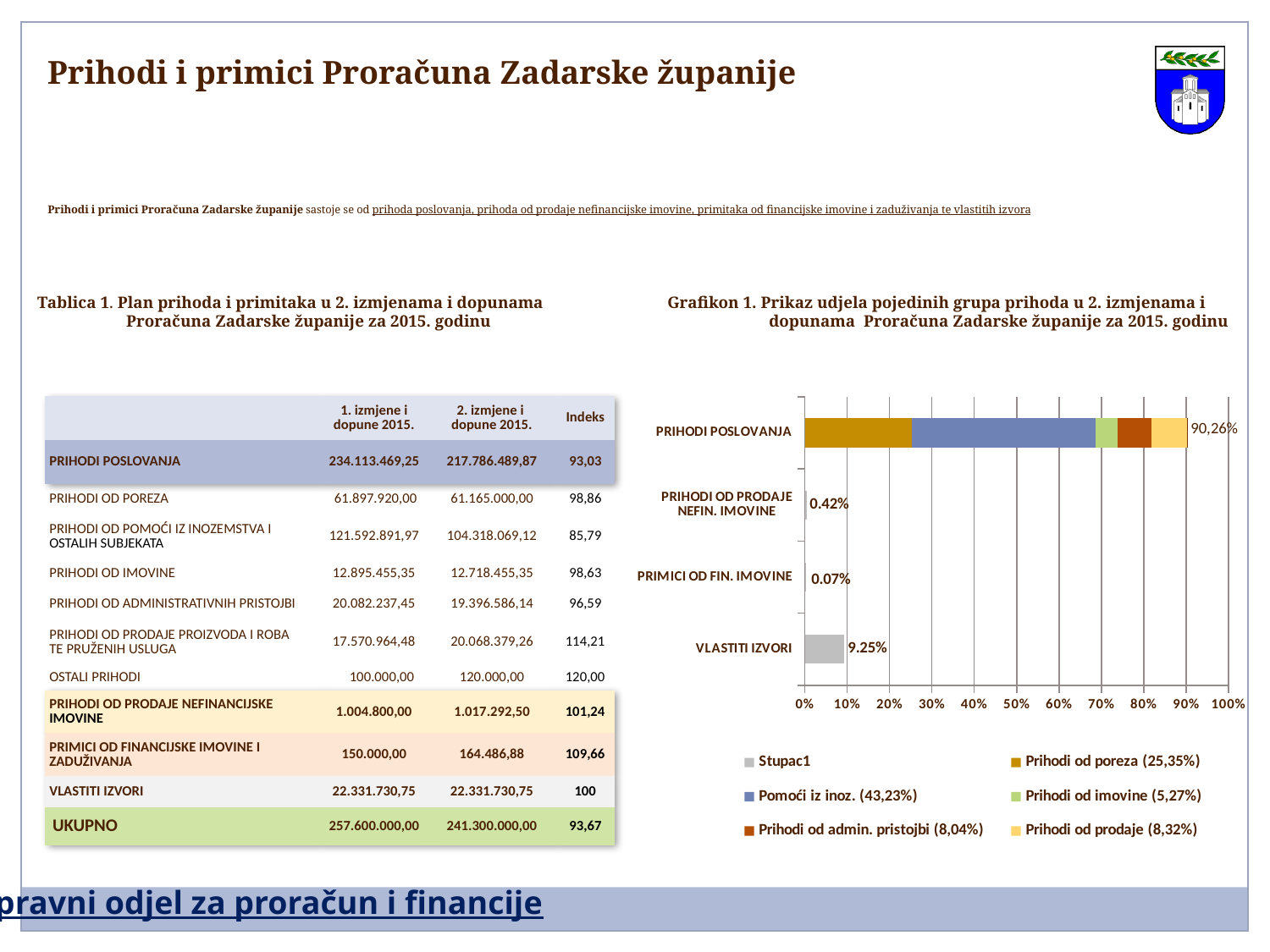
How many entries does the legend of Grafikon 1 list? 6 In Grafikon 1, which category has the smallest share? PRIMICI OD FIN. IMOVINE In Grafikon 1, is the total bar for PRIHODI POSLOVANJA greater or less than 80%? greater In Grafikon 1, which is larger: the value for VLASTITI IZVORI or the value for PRIHODI OD PRODAJE NEFIN. IMOVINE? VLASTITI IZVORI How many categories are shown on the vertical axis of Grafikon 1? 4 In Grafikon 1, which category has the largest share? PRIHODI POSLOVANJA In Grafikon 1, what value is labelled for VLASTITI IZVORI? 9.25% In Grafikon 1, what value is labelled for PRIHODI POSLOVANJA? 90,26% What kind of chart is Grafikon 1? bar chart In the legend of Grafikon 1, what percentage is given for Pomoći iz inoz.? 43,23% In Grafikon 1, what value is labelled for PRIHODI OD PRODAJE NEFIN. IMOVINE? 0.42% In Grafikon 1, what value is labelled for PRIMICI OD FIN. IMOVINE? 0.07%